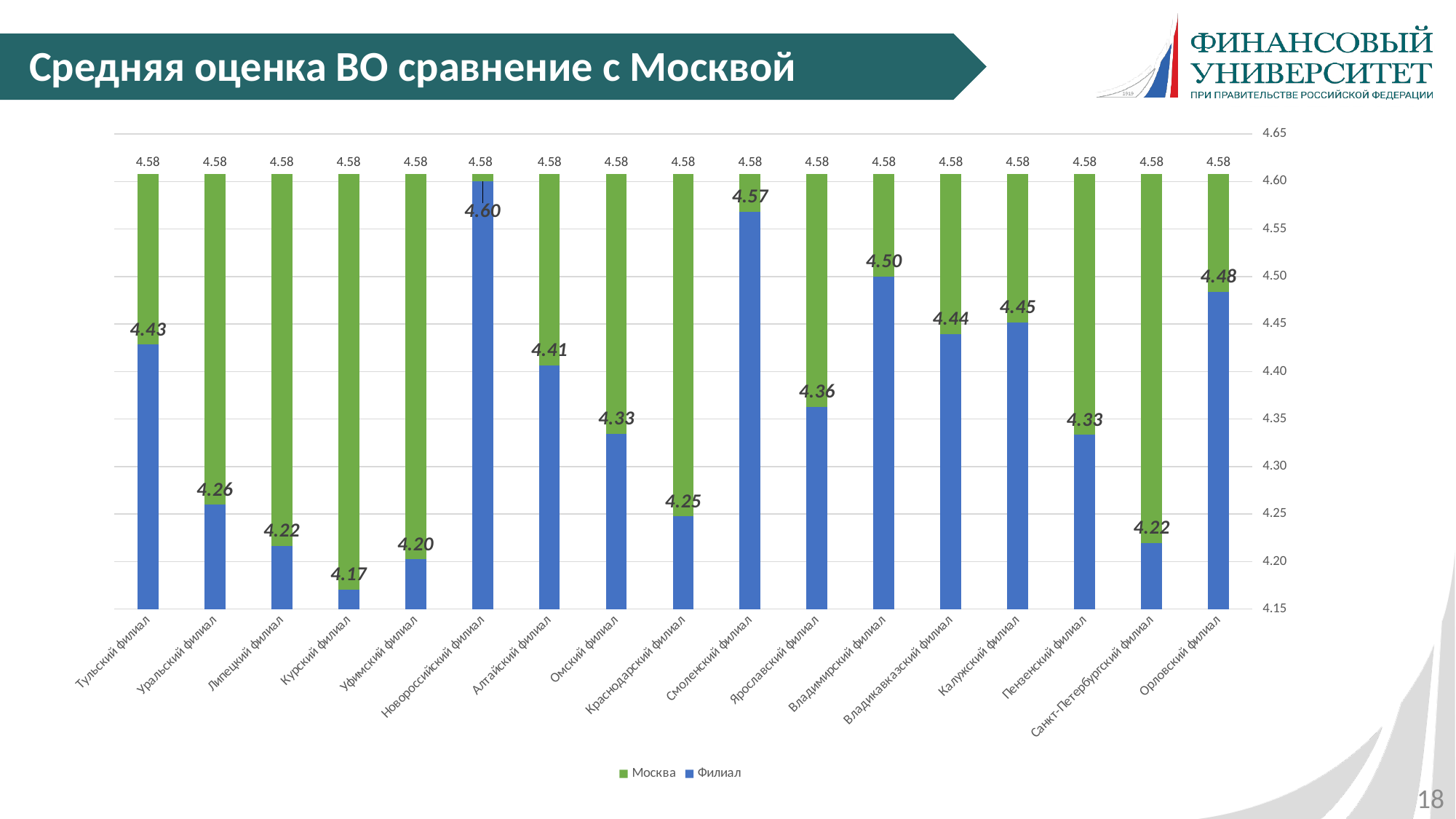
Which colour represents the Москва series in the legend? Green Which is larger: the Филиал value for Смоленский филиал or for Ярославский филиал? Смоленский филиал How many branches are shown on the x axis? 17 What is the Филиал value for Новороссийский филиал? 4.60 What is the Москва value shown for Тульский филиал? 4.58 How many series does the legend list? 2 What is the difference between the Москва value and the Филиал value for Курский филиал? 0.41 What kind of chart is shown on the slide? Bar chart What is the Филиал value for Курский филиал? 4.17 What is the Филиал value for Владимирский филиал? 4.50 Which branch has the lowest Филиал value? Курский филиал Which branch has the highest Филиал value? Новороссийский филиал